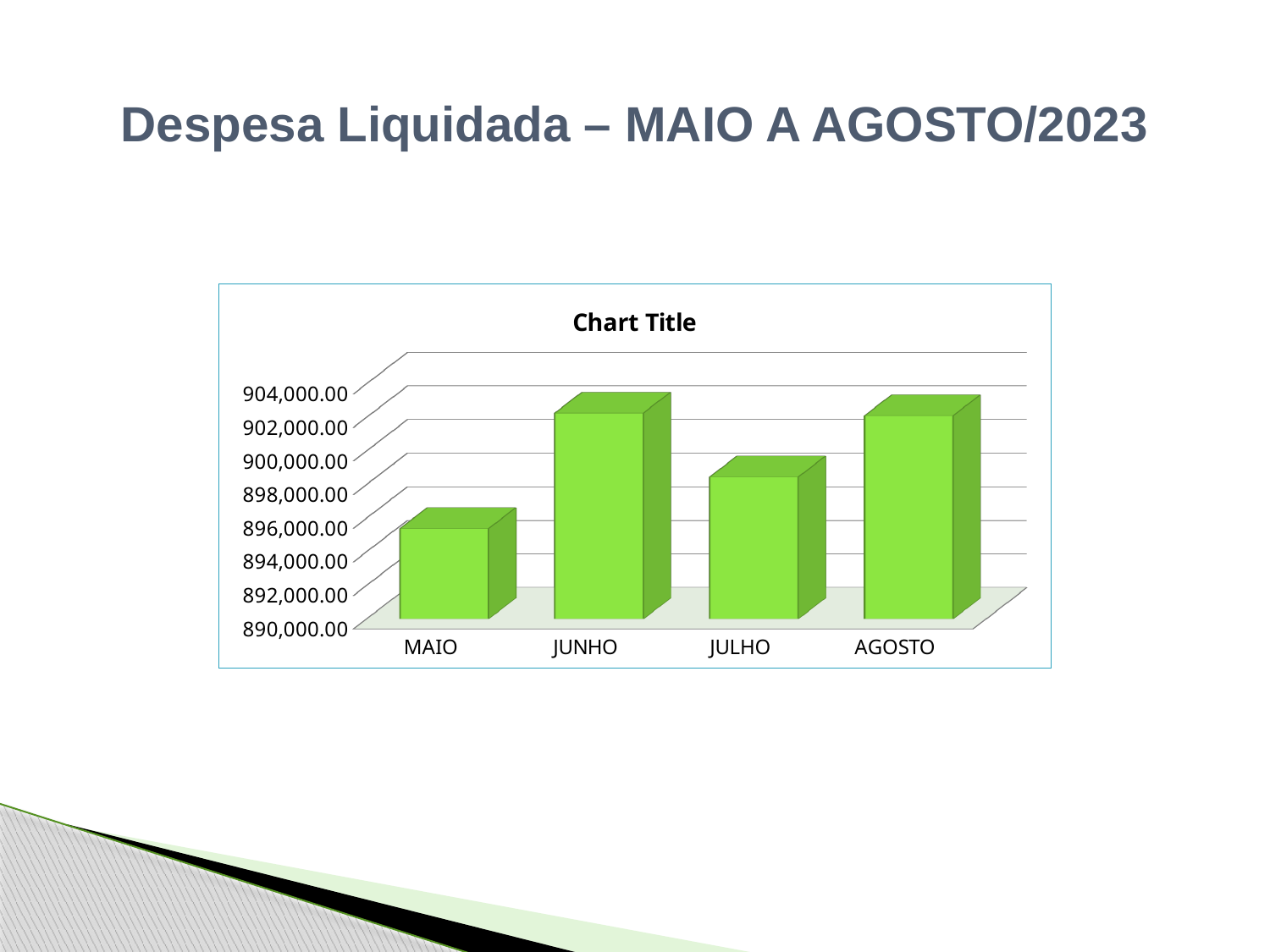
Is the value for JULHO greater or less than 900,000.00? less Which is larger, the value for MAIO or the value for AGOSTO? AGOSTO How many categories are shown on the x axis of the chart? 4 Which is larger, the value for JUNHO or the value for JULHO? JUNHO What is the title printed above the chart? Chart Title Is the value for MAIO greater or less than 898,000.00? less Is the value for AGOSTO greater or less than 900,000.00? greater Which month has the lowest value in the chart? MAIO Does the value rise or fall from MAIO to JUNHO? rise What kind of chart is shown on the slide? bar chart